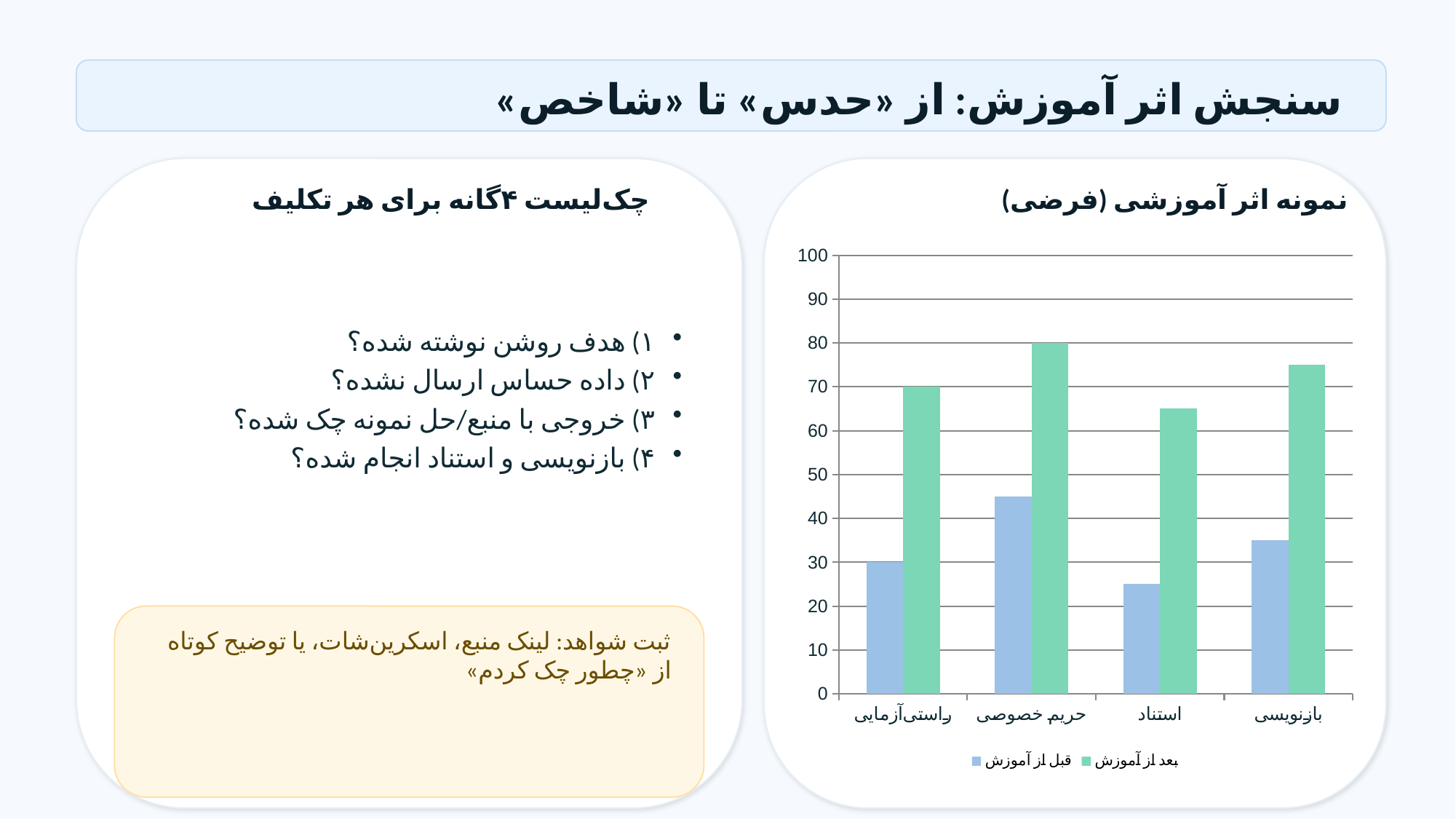
How many categories are shown on the x axis of the chart? 4 For راستی‌آزمایی, what is the difference between بعد از آموزش and قبل از آموزش? 40 Which category has the highest value for بعد از آموزش? حریم خصوصی What is the value of قبل از آموزش for راستی‌آزمایی? 30 Which category has the larger value for بعد از آموزش: بازنویسی or استناد? بازنویسی Which category has the lowest value for قبل از آموزش? استناد What is the value of بعد از آموزش for راستی‌آزمایی? 70 What is the title of the chart? نمونه اثر آموزشی (فرضی) What kind of chart is shown on the slide? bar chart What is the value of بعد از آموزش for حریم خصوصی? 80 Is the value of قبل از آموزش for حریم خصوصی greater or less than 40? greater How many series does the chart legend list? 2